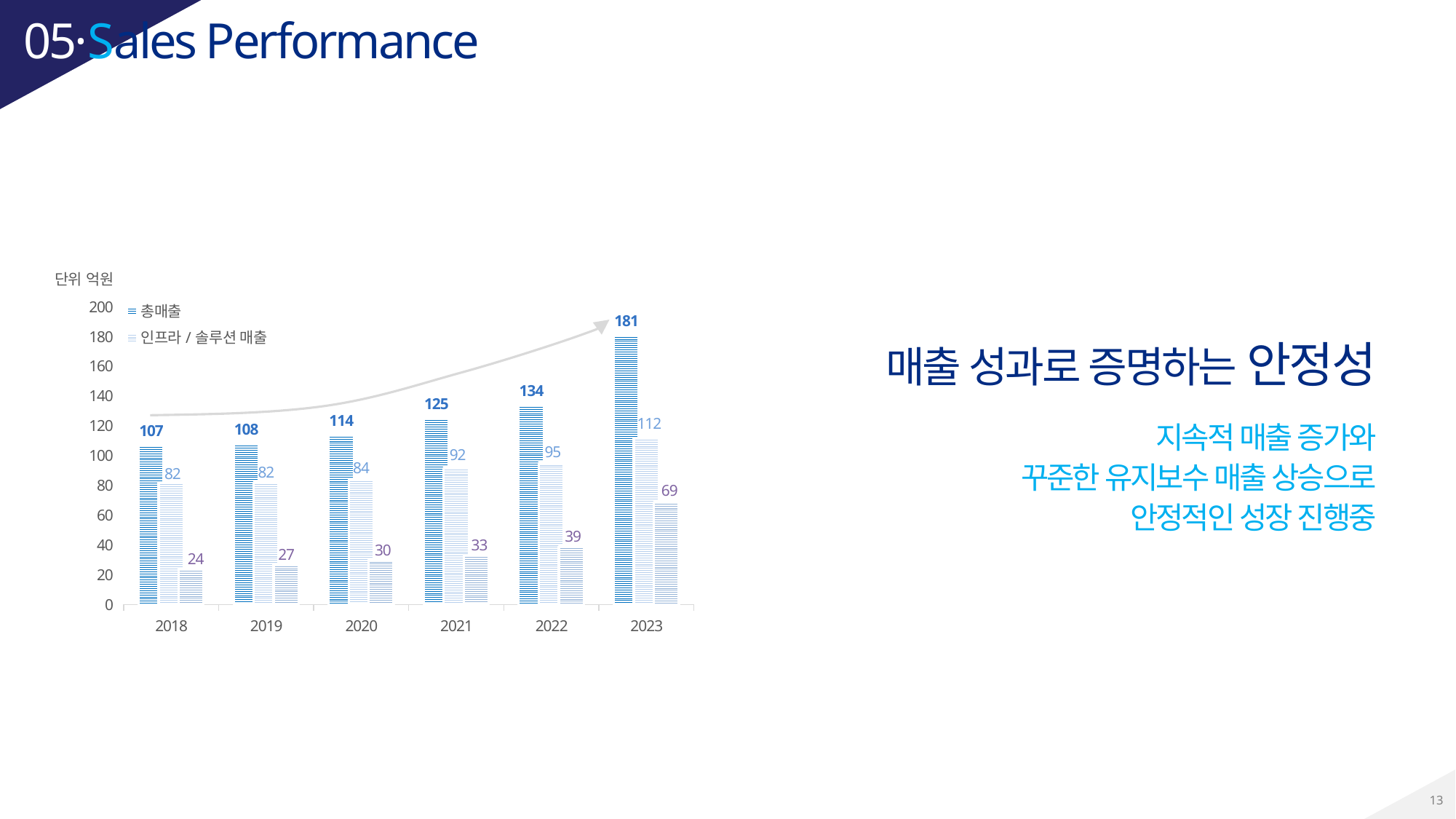
What is the 총매출 value for 2023? 181 How many years are shown on the x axis of the chart? 6 Which year has the larger 인프라 / 솔루션 매출, 2019 or 2020? 2020 What is the 인프라 / 솔루션 매출 value for 2021? 92 What is the difference between the 총매출 values for 2023 and 2022? 47 What is the difference between the 인프라 / 솔루션 매출 values for 2023 and 2018? 30 Which year has the lowest 총매출? 2018 Does the 총매출 value rise or fall from 2018 to 2023? Rise What is the 총매출 value for 2020? 114 How many series does the chart's legend list? 2 What kind of chart is shown on the slide? Bar chart Which year has the highest 총매출? 2023